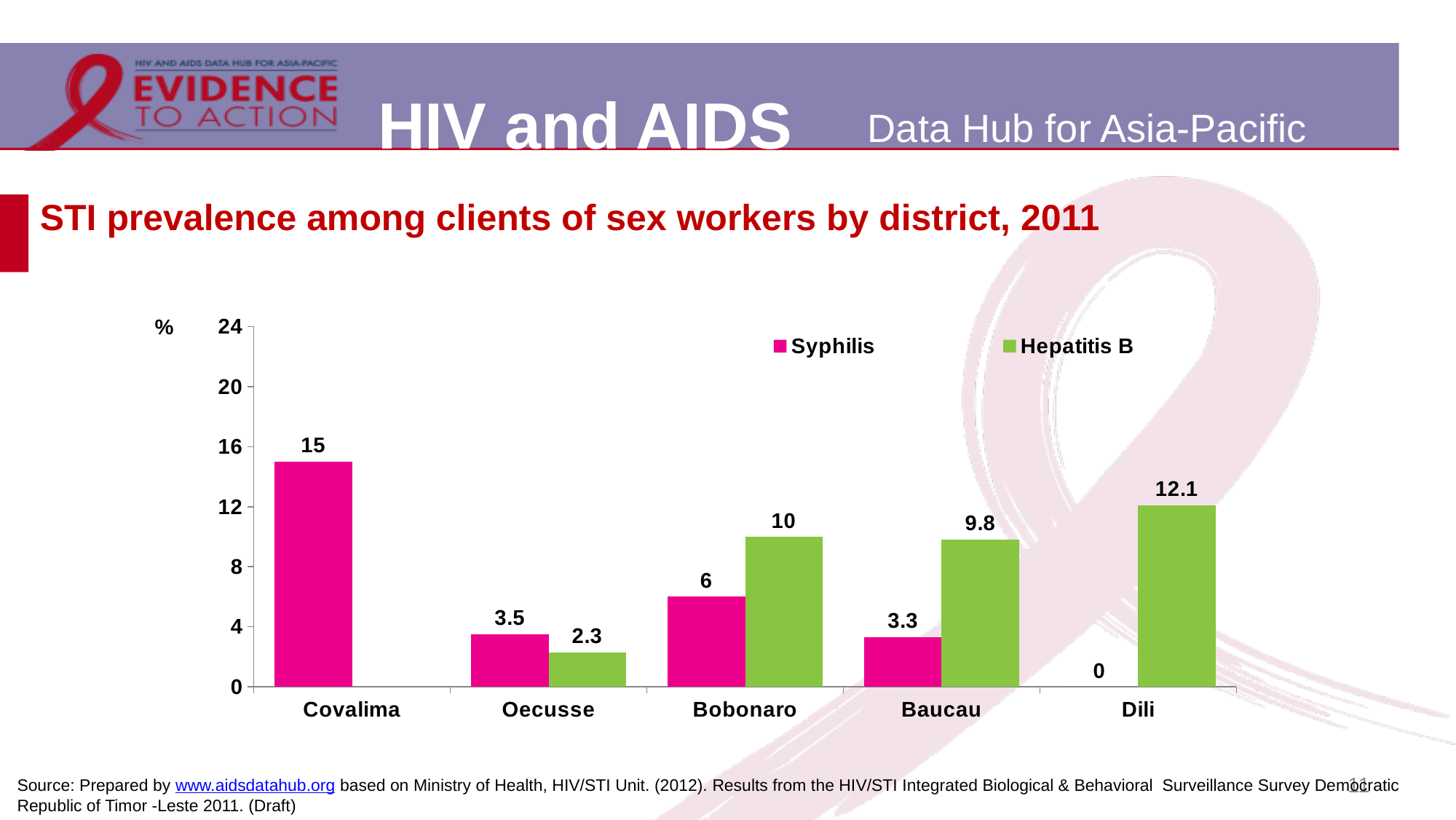
What is the Syphilis value for Oecusse? 3.5 Which district has the highest Syphilis prevalence? Covalima What is the Syphilis prevalence for Covalima? 15 What kind of chart is shown on the slide? Bar chart Which is larger for Oecusse, the Syphilis value or the Hepatitis B value? Syphilis What is the Hepatitis B prevalence for Dili? 12.1 What colour represents Hepatitis B in the chart? Green What is the difference between the Hepatitis B and Syphilis values for Bobonaro? 4 How many series does the legend list? 2 Which district has the lowest Hepatitis B value among those with a labelled Hepatitis B bar? Oecusse What is the Hepatitis B value for Baucau? 9.8 How many districts are shown on the x axis? 5